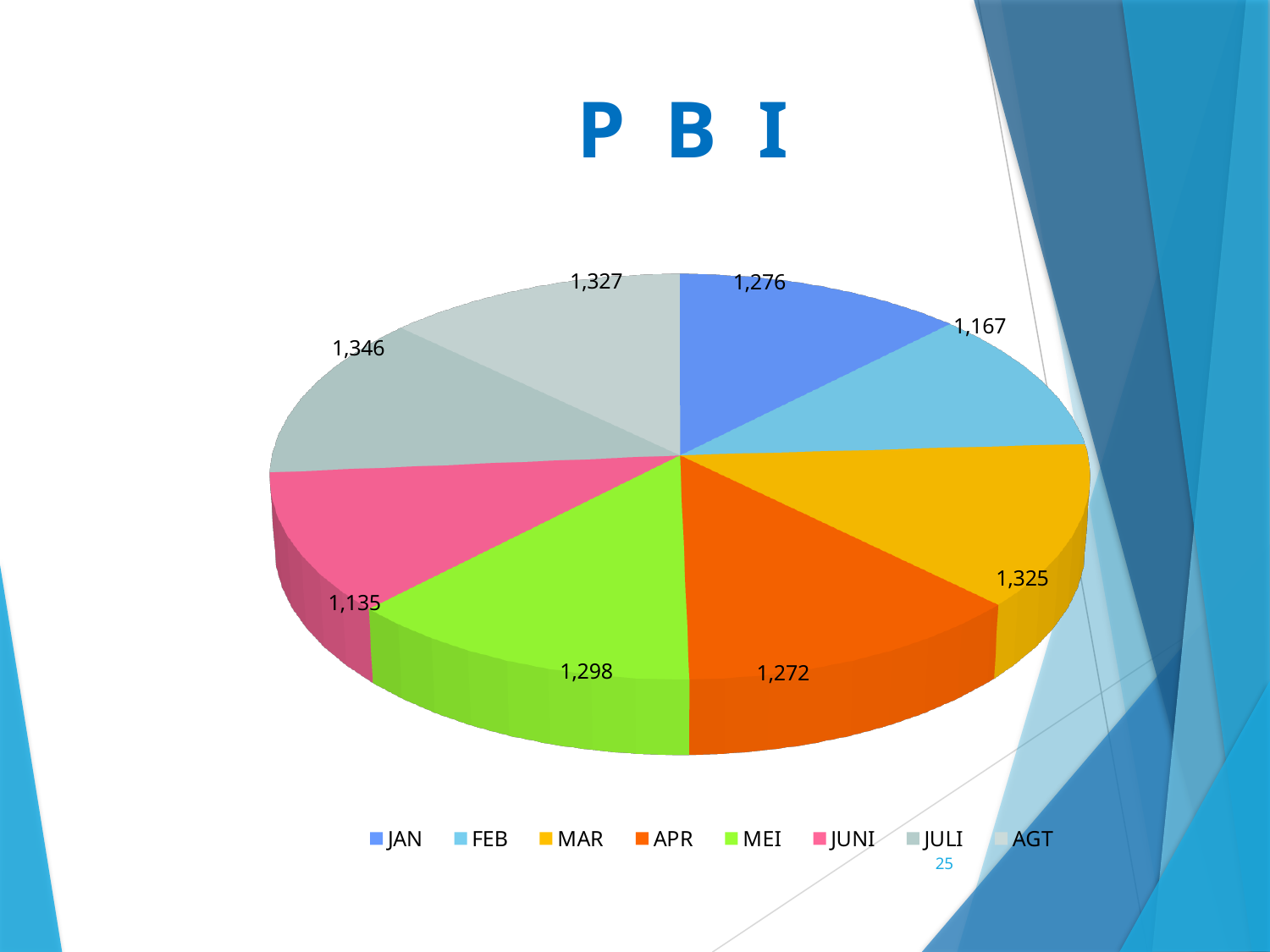
What colour is the slice for APR? orange What is the value for JAN? 1,276 What is the value for AGT? 1,327 Which month has the lowest value? JUNI What is the value for FEB? 1,167 What is the value for MEI? 1,298 How many slices does the pie chart have? 8 Which month has the highest value? JULI What type of chart is shown on the slide? pie chart What is the title of the chart? P B I What is the difference between the values for JULI and JUNI? 211 Which is larger, the value for MAR or the value for FEB? MAR